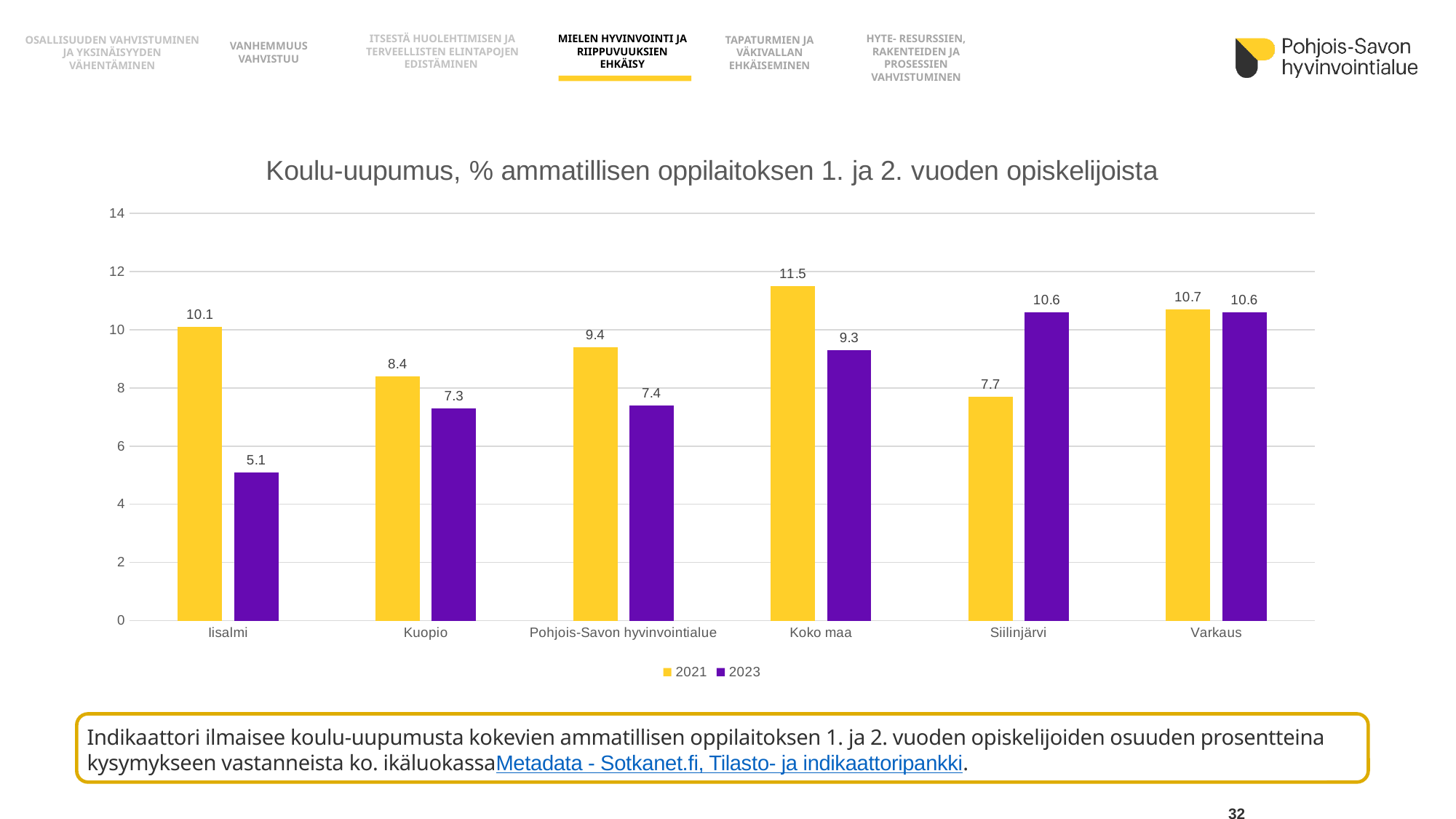
Which category has the highest value in 2021? Koko maa What kind of chart is shown on the slide? bar chart What is the difference between the 2021 and 2023 values for Iisalmi? 5 Is the 2023 value for Pohjois-Savon hyvinvointialue greater or less than 8? less What is the value for Koko maa in 2021? 11.5 What is the title of the chart? Koulu-uupumus, % ammatillisen oppilaitoksen 1. ja 2. vuoden opiskelijoista What is the value for Iisalmi in 2021? 10.1 Which is larger for Siilinjärvi, the 2021 value or the 2023 value? 2023 Which category has the lowest value in 2023? Iisalmi How many categories are shown on the x axis? 6 What is the value for Kuopio in 2023? 7.3 How many series does the legend list? 2